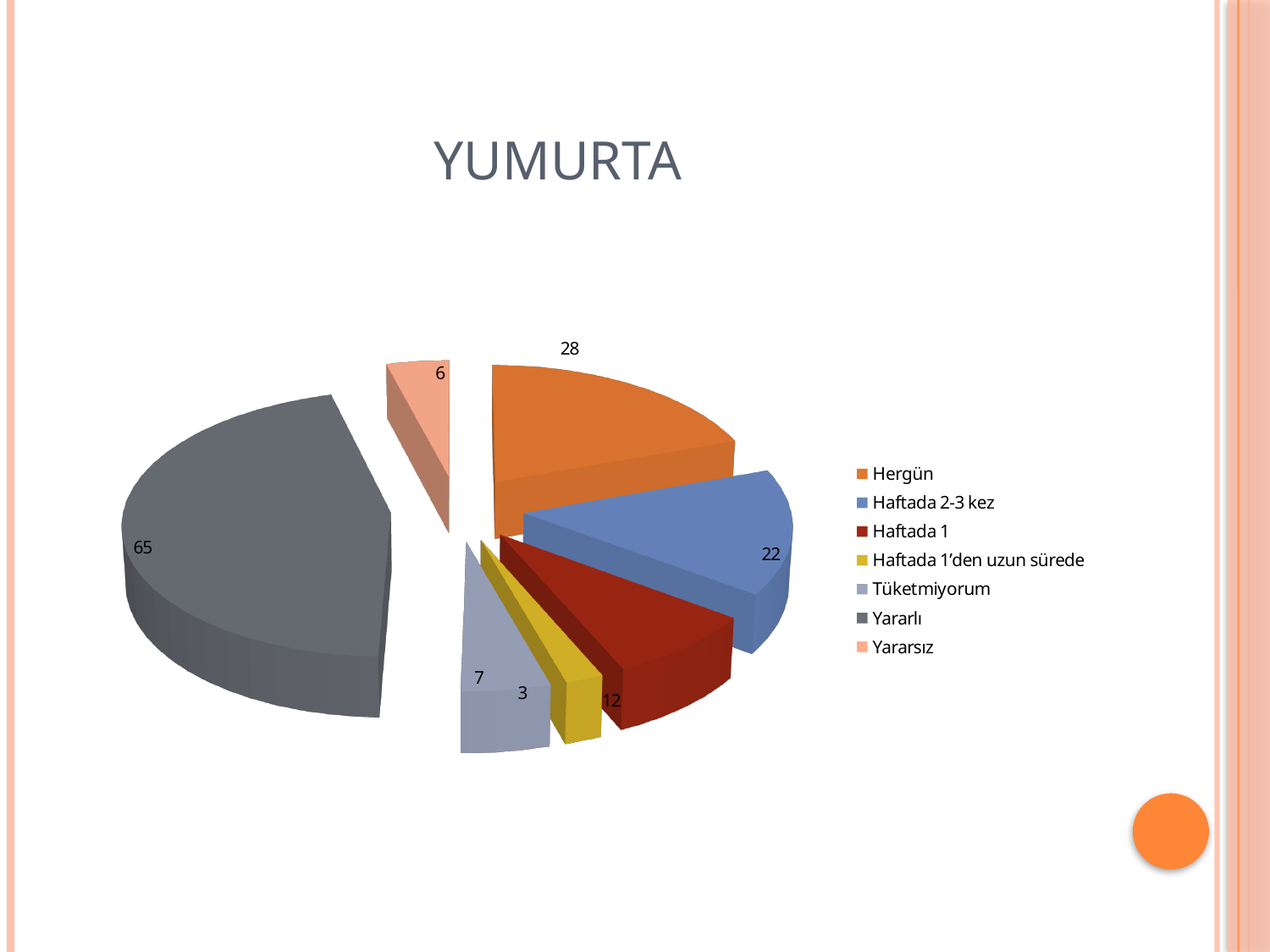
How many categories does the pie chart have? 7 What is the value for Yararsız? 6 Which category has the largest slice? Yararlı What is the difference between the values for Yararlı and Yararsız? 59 What is the value for Yararlı? 65 Which category has the smallest slice? Haftada 1'den uzun sürede What is the title of the slide? YUMURTA What is the difference between the values for Hergün and Haftada 2-3 kez? 6 What is the value for Haftada 1'den uzun sürede? 3 What is the value for Hergün? 28 Which is larger, Haftada 1 or Tüketmiyorum? Haftada 1 What kind of chart is shown on the slide? pie chart